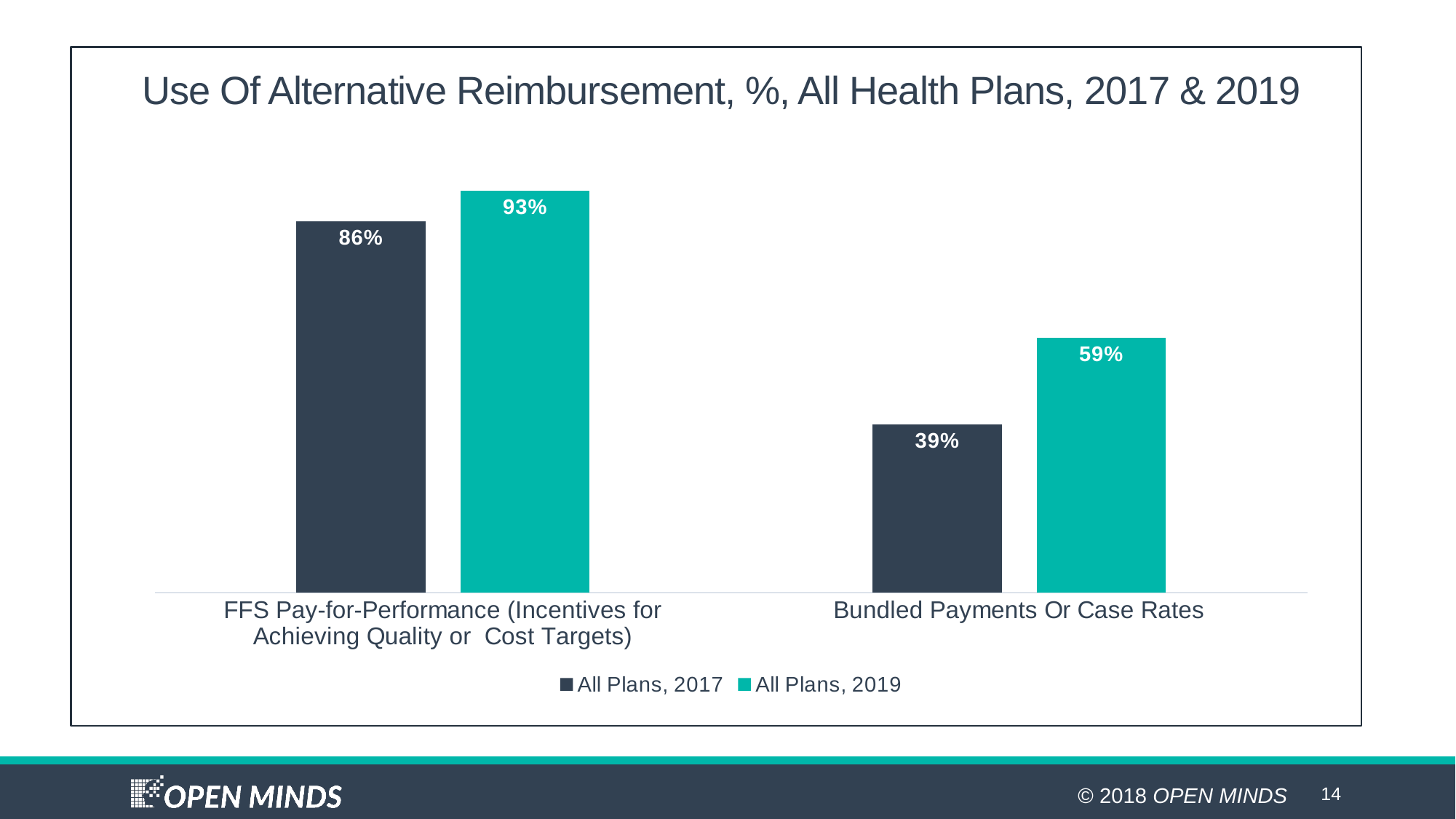
Which is larger for Bundled Payments Or Case Rates: All Plans, 2017 or All Plans, 2019? All Plans, 2019 What kind of chart is shown on the slide? Bar chart Which category has the highest value for All Plans, 2019? FFS Pay-for-Performance (Incentives for Achieving Quality or Cost Targets) What is the value for FFS Pay-for-Performance for All Plans, 2019? 93% What is the value for Bundled Payments Or Case Rates for All Plans, 2019? 59% What is the value for Bundled Payments Or Case Rates for All Plans, 2017? 39% Which category has the lowest value for All Plans, 2017? Bundled Payments Or Case Rates How many series does the legend list? 2 What is the difference between the 2019 and 2017 values for FFS Pay-for-Performance? 7% How many categories are shown on the x axis? 2 What is the difference between the 2019 and 2017 values for Bundled Payments Or Case Rates? 20% What is the value for FFS Pay-for-Performance for All Plans, 2017? 86%